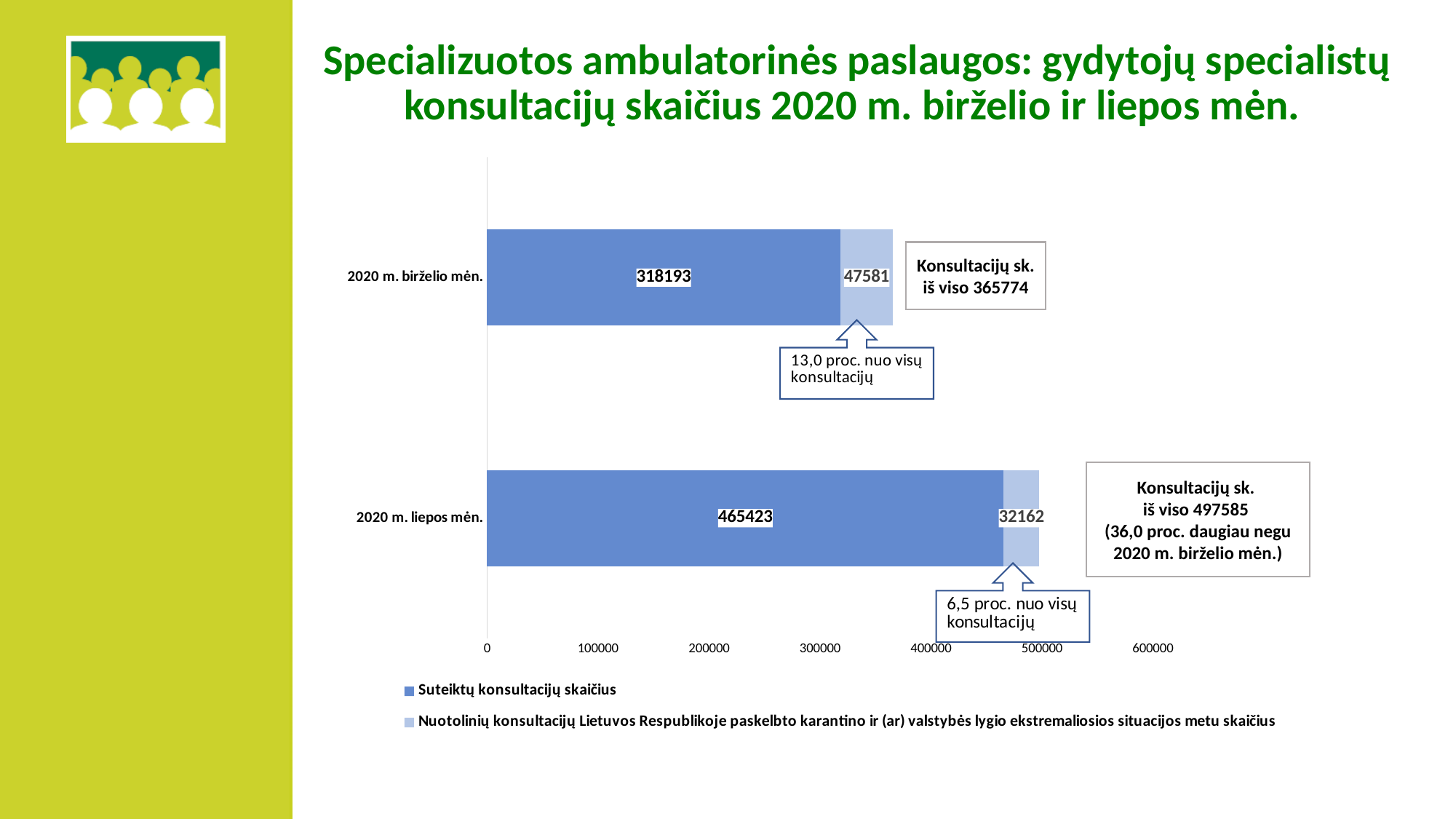
What is the value of 'Suteiktų konsultacijų skaičius' for 2020 m. birželio mėn.? 318193 How many series does the legend list? 2 What is the value of 'Suteiktų konsultacijų skaičius' for 2020 m. liepos mėn.? 465423 What is the difference between the 'Suteiktų konsultacijų skaičius' values for 2020 m. liepos mėn. and 2020 m. birželio mėn.? 147230 Which month has the lower value for the remote consultations series? 2020 m. liepos mėn. What is the value of the remote consultations series (Nuotolinių konsultacijų ... skaičius) for 2020 m. liepos mėn.? 32162 What is the total of the stacked bar for 2020 m. liepos mėn.? 497585 Is the 'Suteiktų konsultacijų skaičius' value for 2020 m. birželio mėn. greater or less than 300000? greater What is the total of the stacked bar for 2020 m. birželio mėn.? 365774 Which month has the higher value for 'Suteiktų konsultacijų skaičius'? 2020 m. liepos mėn. What is the value of the remote consultations series (Nuotolinių konsultacijų ... skaičius) for 2020 m. birželio mėn.? 47581 What kind of chart is shown on the slide? Stacked bar chart